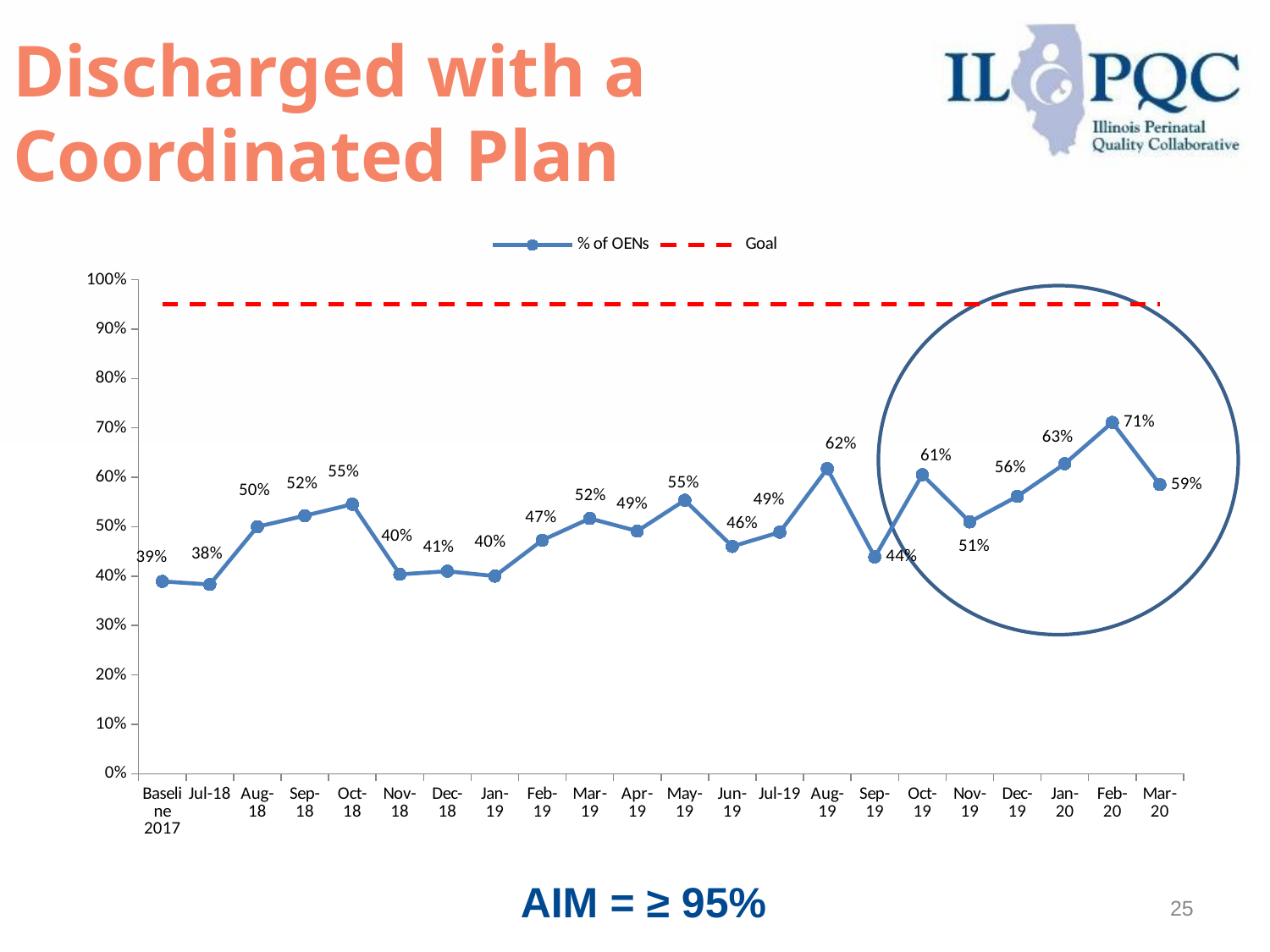
What is the value for Feb-20? 71% What is the value for Aug-19? 62% What is the name of the series shown as a red dashed line? Goal Which is larger, the value for Oct-18 or the value for Oct-19? Oct-19 What is the difference between the values for Feb-20 and Mar-20? 12% Which month has the lowest % of OENs? Jul-18 What is the value for Baseline 2017? 39% How many data points are plotted on the % of OENs line? 22 What kind of chart is shown on the slide? line chart Which month has the highest % of OENs? Feb-20 Is the value for Sep-19 greater or less than 50%? less How many series does the legend list? 2